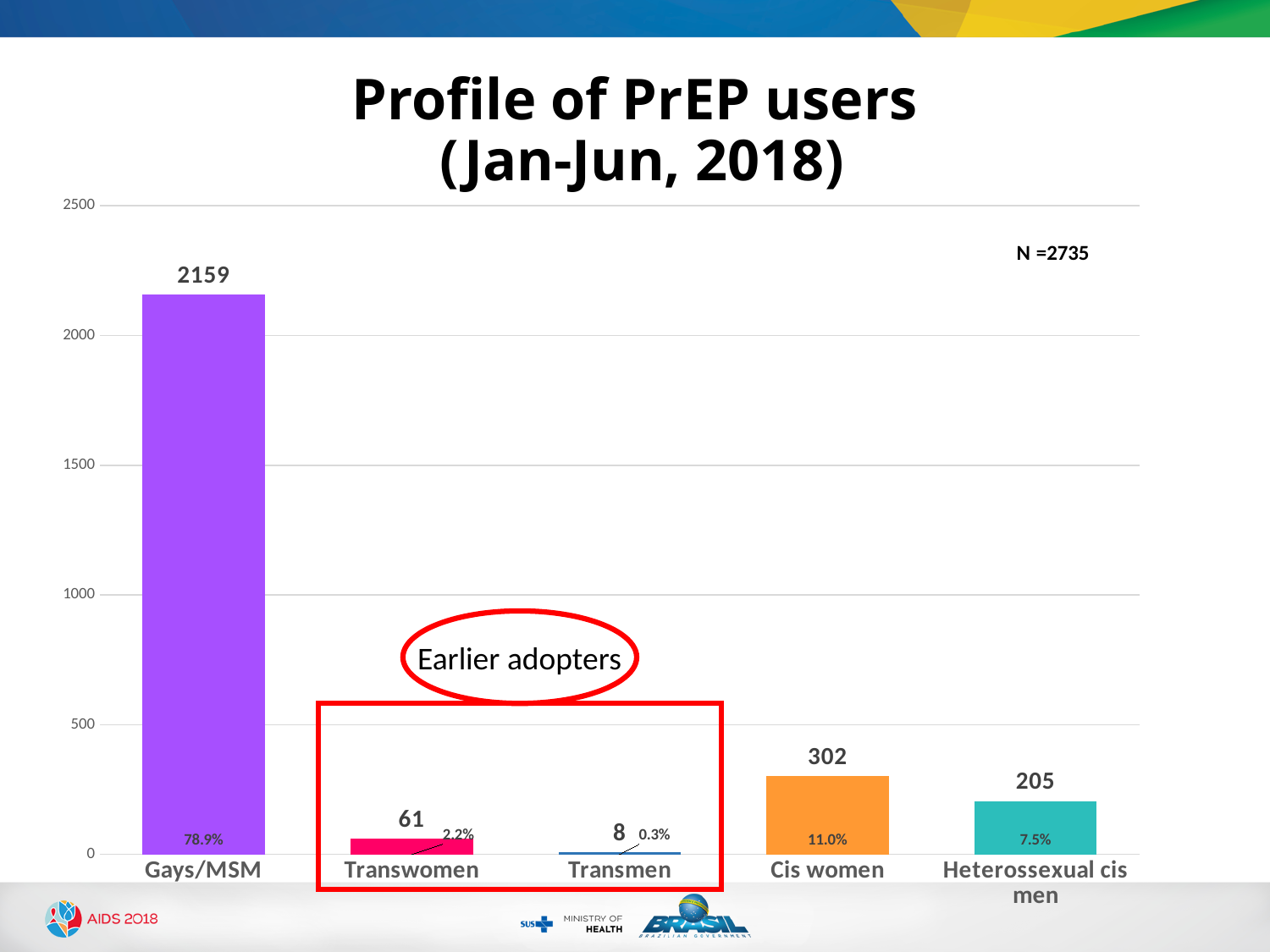
Which is larger, the value for Transwomen or the value for Heterossexual cis men? Heterossexual cis men What is the value for Cis women? 302 Is the value for Gays/MSM greater or less than 2000? greater Which category has the highest value? Gays/MSM What is the difference between the values for Cis women and Heterossexual cis men? 97 What is the title of the chart? Profile of PrEP users (Jan-Jun, 2018) What is the value for Transmen? 8 Which category has the lowest value? Transmen What percentage is shown for Heterossexual cis men? 7.5% How many categories are shown on the x axis? 5 What is the value for Gays/MSM? 2159 What kind of chart is shown on the slide? bar chart